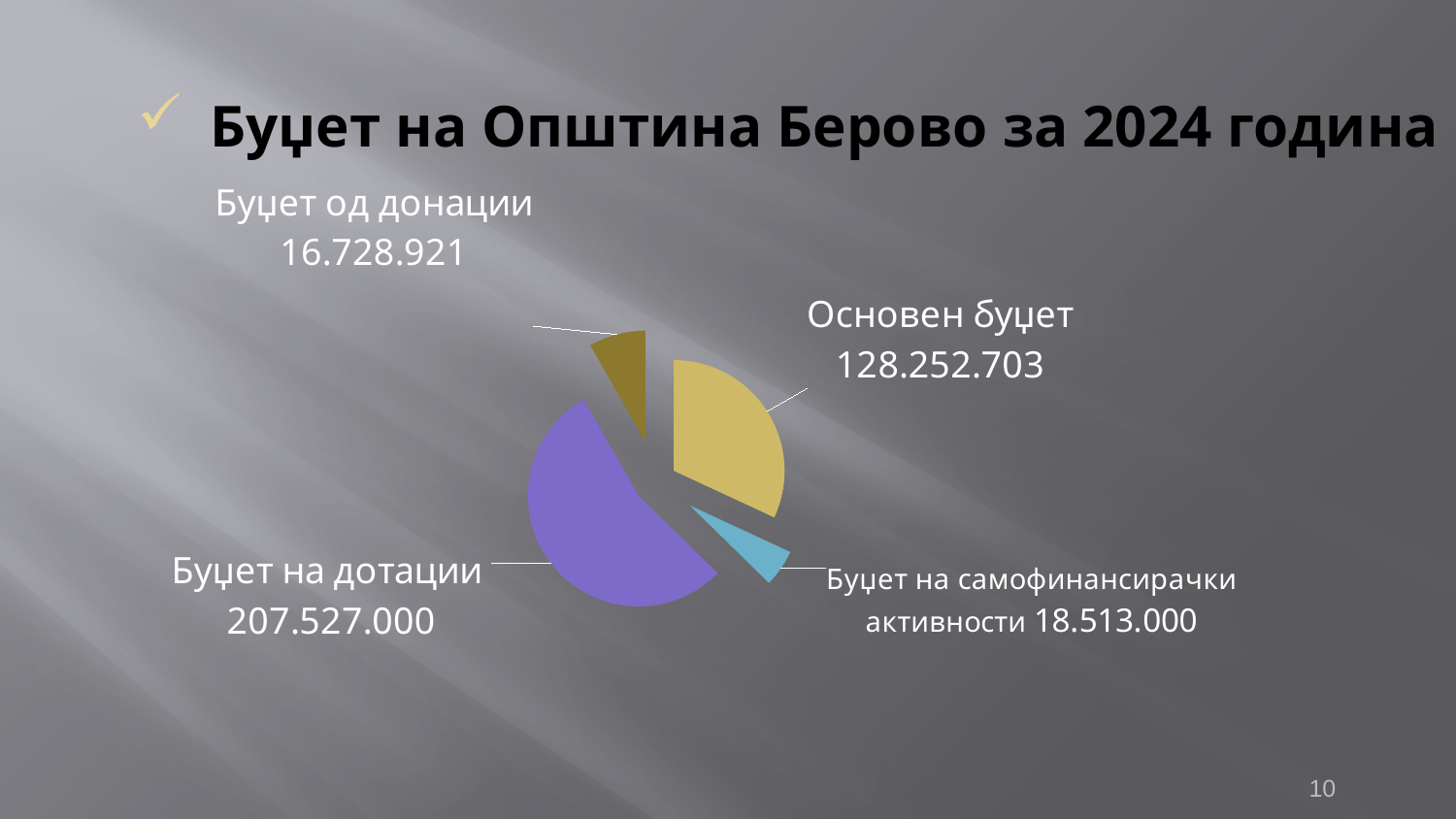
What is the total of all four budget values shown in the pie chart? 371.021.624 What is the value shown for Буџет на самофинансирачки активности? 18.513.000 Which is larger, Буџет на самофинансирачки активности or Буџет од донации? Буџет на самофинансирачки активности How many slices does the pie chart have? 4 What is the value shown for Основен буџет? 128.252.703 What is the value shown for Буџет од донации? 16.728.921 What kind of chart is shown on the slide? Pie chart What is the title of the slide containing the pie chart? Буџет на Општина Берово за 2024 година Which category has the largest slice of the pie chart? Буџет на дотации What is the value of the Буџет на дотации slice in the pie chart? 207.527.000 What is the difference between Буџет на дотации and Основен буџет? 79.274.297